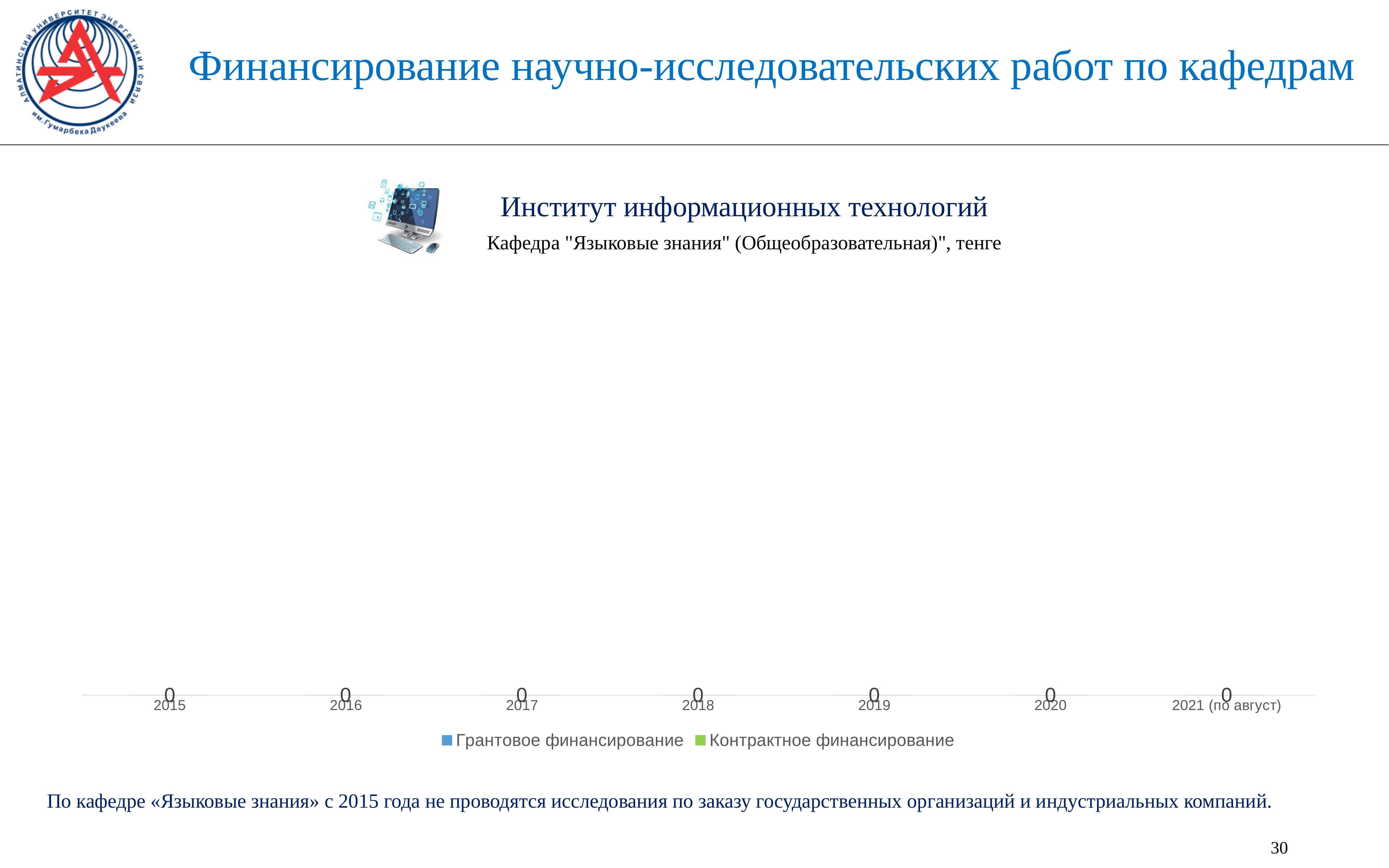
What is the difference between the labelled values for 2016 and 2020? 0 What value is labelled for 2021 (по август) on the chart? 0 Do the labelled values rise, fall, or stay the same from 2015 to 2021 (по август)? stay the same What is the total labelled value for 2019? 0 What value is labelled for 2015 on the chart? 0 What is the title of the chart? Кафедра "Языковые знания" (Общеобразовательная)", тенге What is the label of the last category on the x axis? 2021 (по август) Which series is shown in green in the chart legend? Контрактное финансирование How many year categories are shown on the x axis of the chart? 7 What value is labelled for 2018 on the chart? 0 How many series does the chart legend list? 2